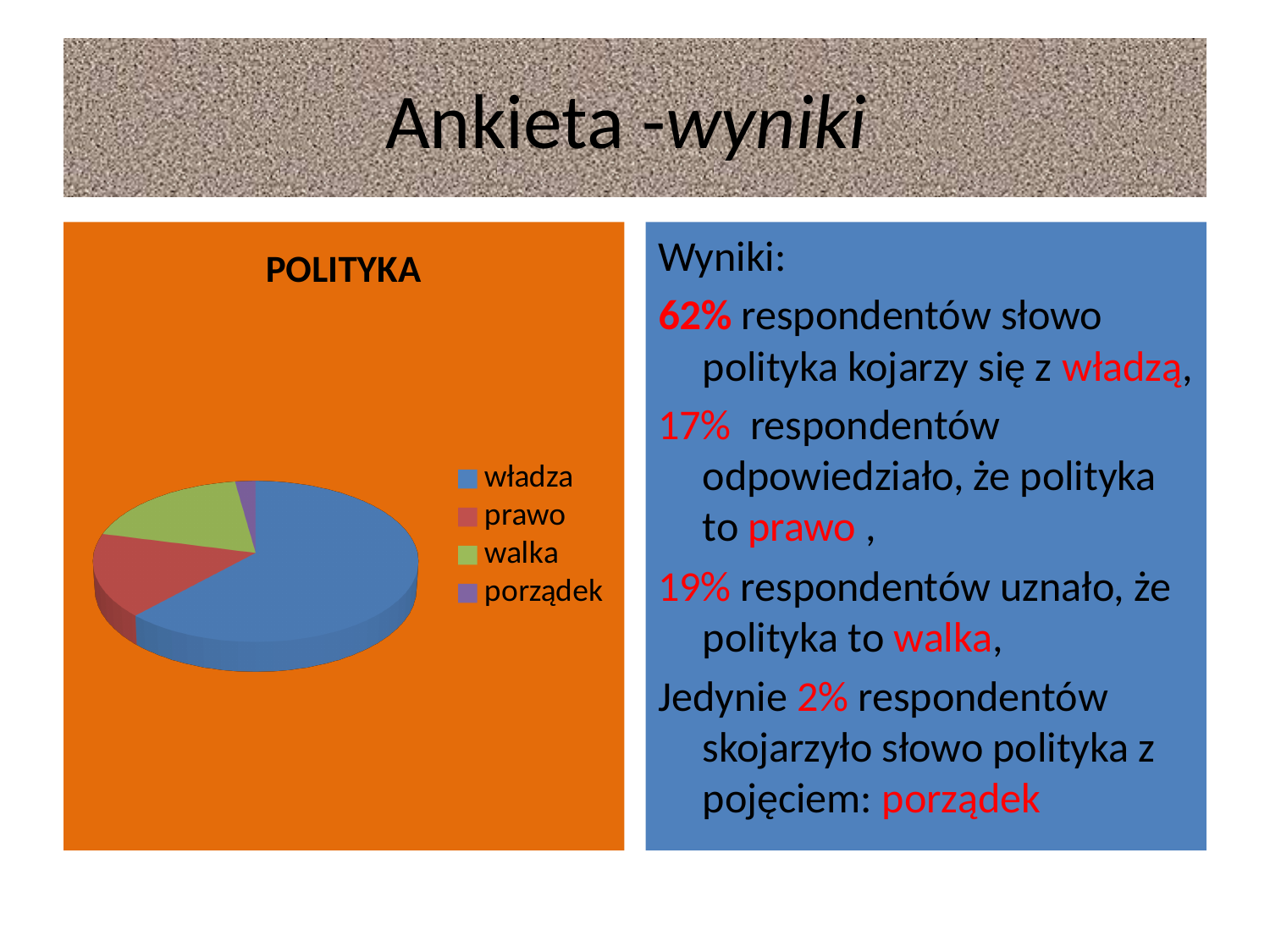
What share of respondents associated politics with prawo? 17% What share of respondents associated politics with walka? 19% What is the title of the chart? POLITYKA How many categories does the pie chart have? 4 What kind of chart is shown on the slide? pie chart Which category has the smallest slice of the pie? porządek Which category has the largest slice of the pie? władza What share of respondents associated politics with władza? 62% Which slice is larger, walka or porządek? walka Which slice is larger, władza or prawo? władza What colour is the władza slice in the pie chart? blue